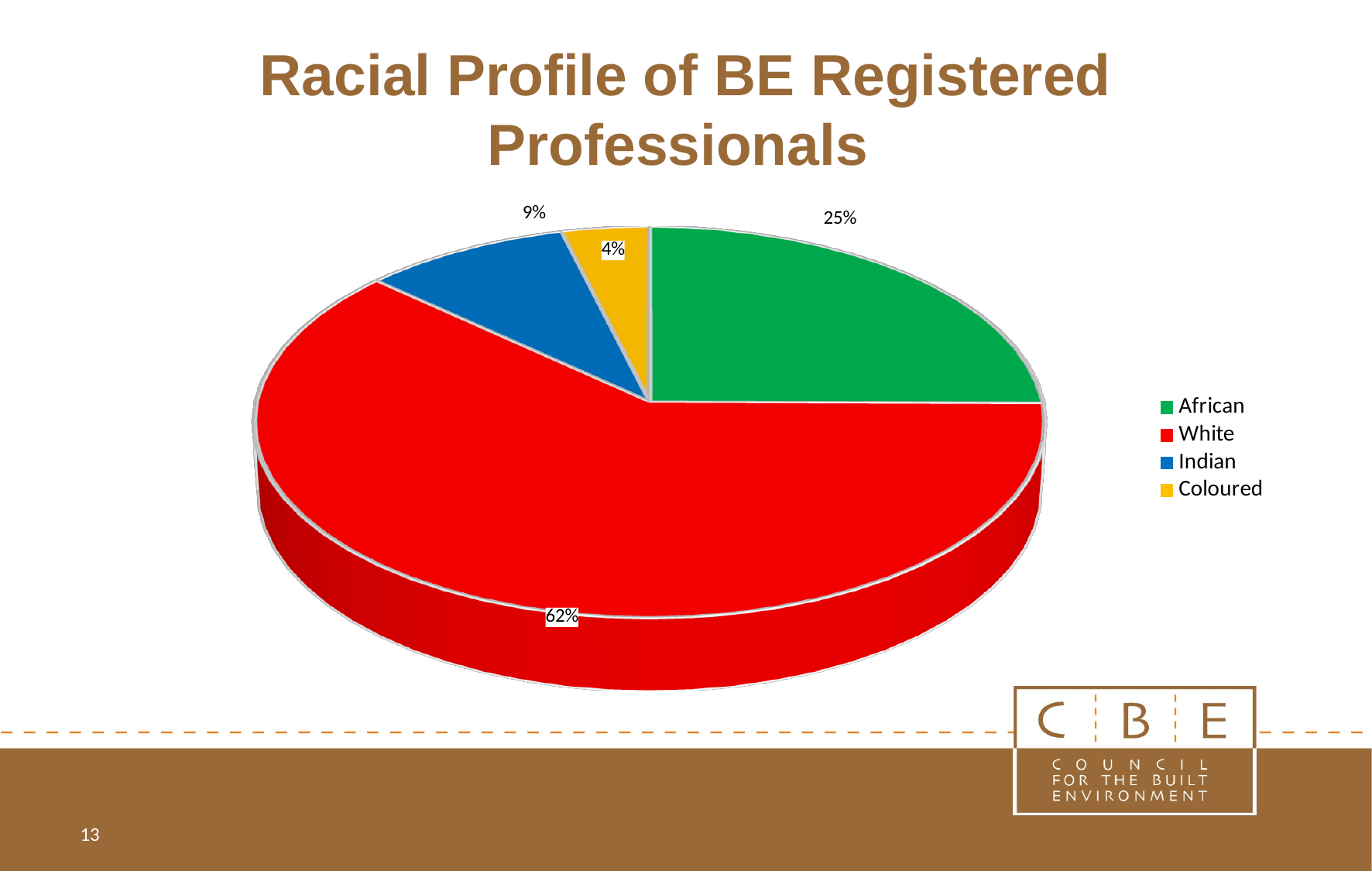
What percentage of BE registered professionals are Indian? 9% How many racial groups are shown in the pie chart? 4 What percentage of BE registered professionals are African? 25% Which racial group has the largest share of BE registered professionals? White Which racial group has the smallest share of BE registered professionals? Coloured Which colour represents African in the pie chart? Green What percentage of BE registered professionals are Coloured? 4% Which share is larger, Indian or Coloured? Indian What percentage of BE registered professionals are White? 62% What is the difference in percentage points between the White and African shares? 37 What is the title of the chart? Racial Profile of BE Registered Professionals What kind of chart is shown on the slide? Pie chart